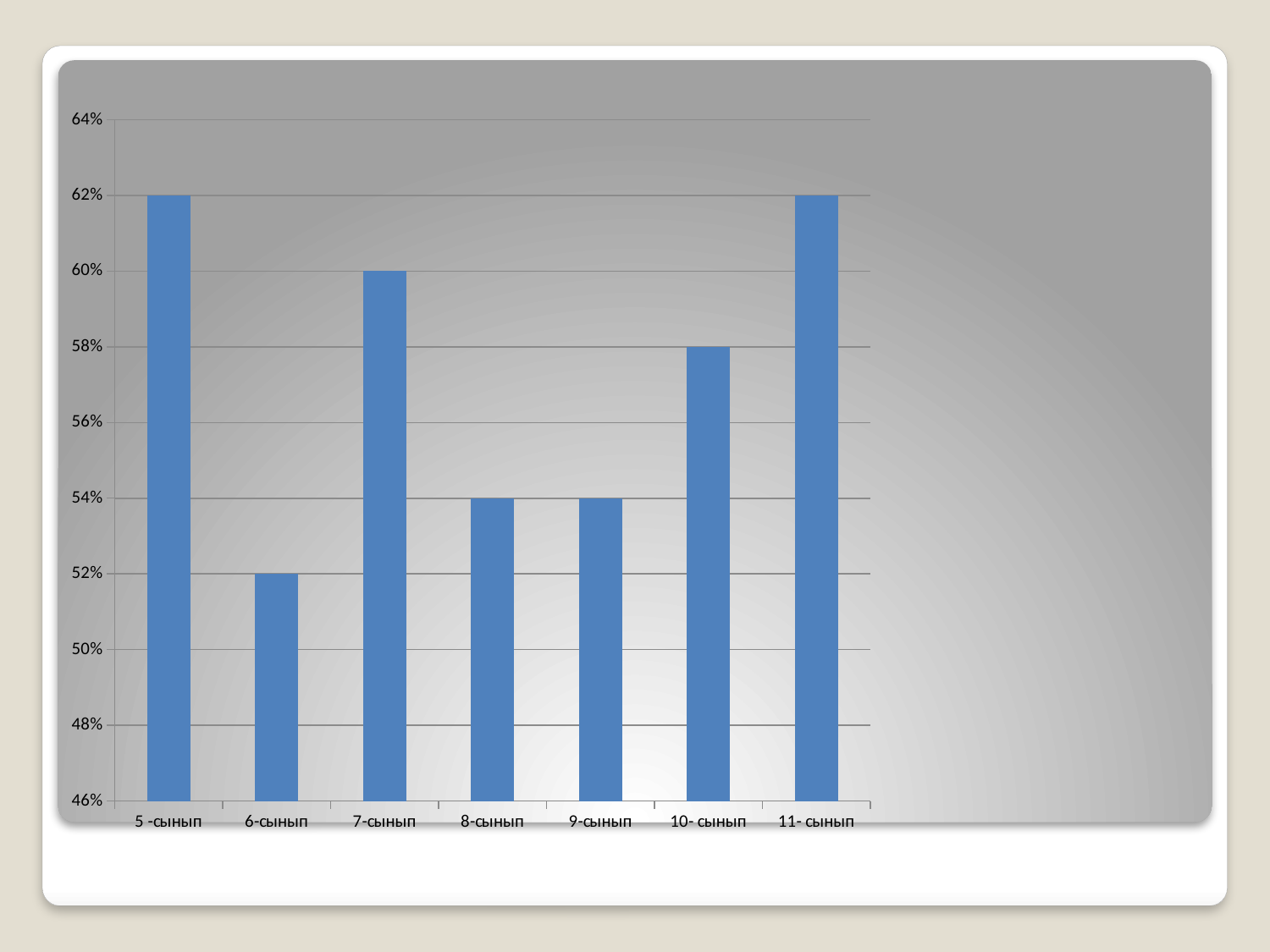
What kind of chart is shown on the slide? bar chart How many categories are shown on the x axis? 7 Which category has the lowest value? 6-сынып What is the value for 10- сынып? 58% What is the difference between the values for 7-сынып and 10- сынып? 2% Which is larger, the value for 7-сынып or the value for 10- сынып? 7-сынып What is the difference between the values for 5 -сынып and 6-сынып? 10% What is the value for 5 -сынып? 62% What is the value for 6-сынып? 52% Does the value rise or fall from 9-сынып to 10- сынып? rise Is the value for 8-сынып greater or less than 56%? less What is the value for 7-сынып? 60%